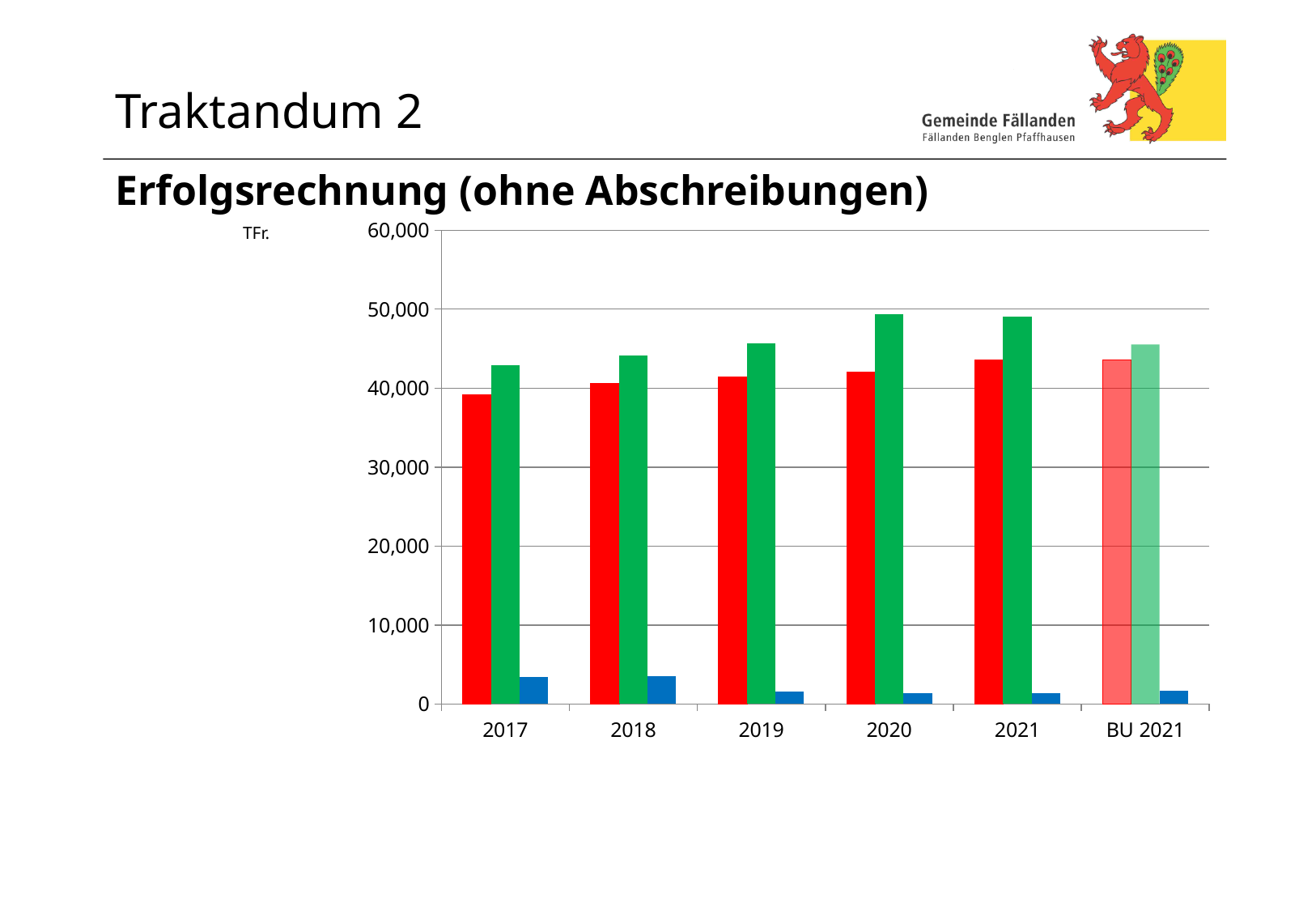
Is the value of the red bar for 2017 greater or less than 40,000? less In 2017, which is larger: the red bar or the green bar? the green bar Is the value of the blue bar for 2017 greater or less than 10,000? less Which year has the lowest red bar? 2017 Which is larger: the blue bar for 2018 or the blue bar for 2019? the blue bar for 2018 Is the value of the red bar for 2021 greater or less than 40,000? greater What kind of chart is shown on the slide? bar chart What unit label is shown next to the vertical axis of the chart? TFr. What is the title of the chart? Erfolgsrechnung (ohne Abschreibungen) How many categories are shown on the x axis of the chart? 6